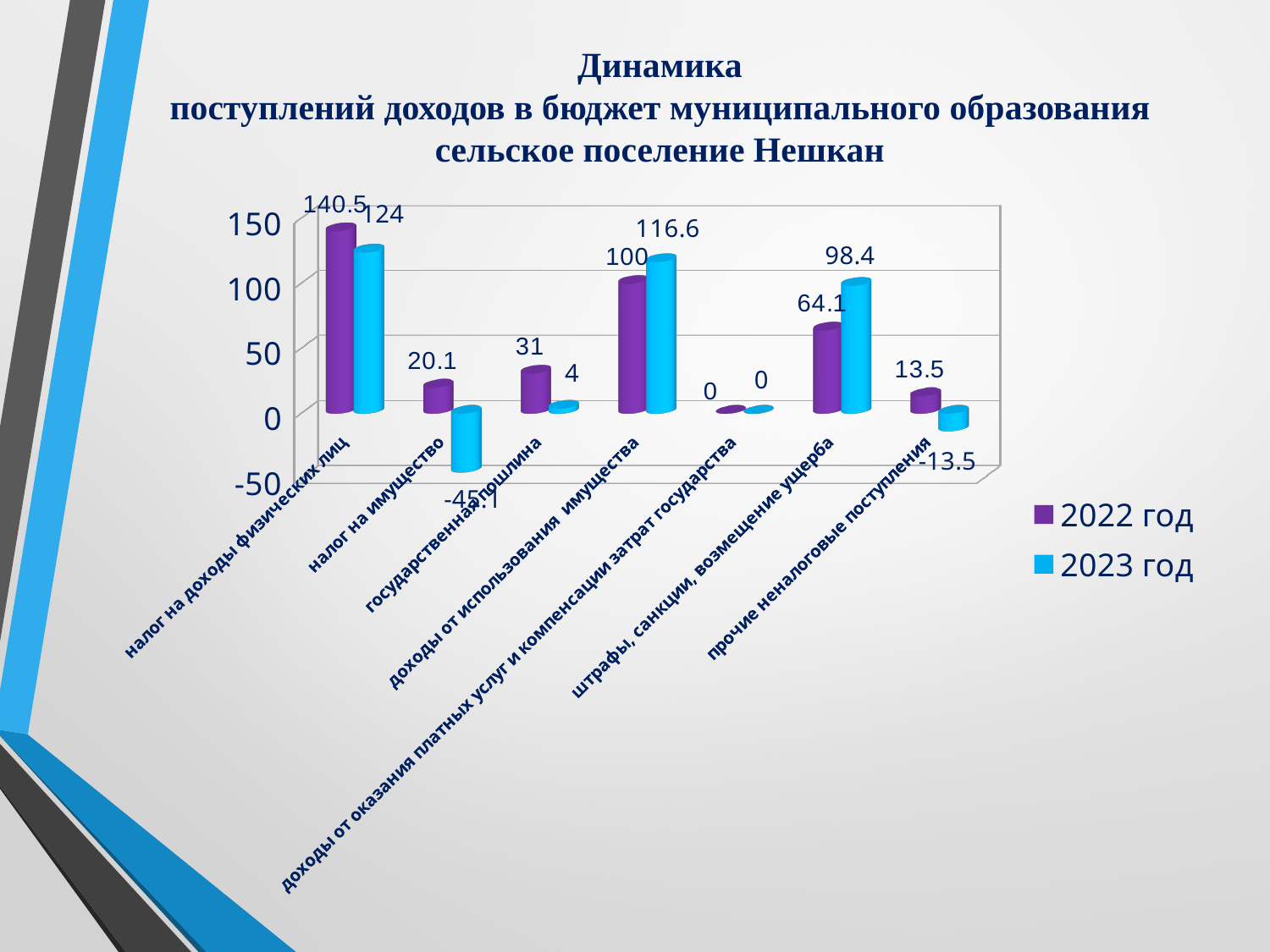
Which category has the lowest value in the 2023 год series? налог на имущество What is the value for 'штрафы, санкции, возмещение ущерба' in the 2023 год series? 98.4 What is the value for 'прочие неналоговые поступления' in the 2023 год series? -13.5 What is the value for 'налог на доходы физических лиц' in the 2022 год series? 140.5 How many series does the legend list? 2 For 'государственная пошлина', which series has the larger value, 2022 год or 2023 год? 2022 год What type of chart is shown on the slide? bar chart Which category has the highest value in the 2022 год series? налог на доходы физических лиц What is the difference between the 2023 год and 2022 год values for 'доходы от использования имущества'? 16.6 How many categories are shown on the x axis? 7 Which series is shown in purple in the legend? 2022 год What is the value for 'налог на доходы физических лиц' in the 2023 год series? 124